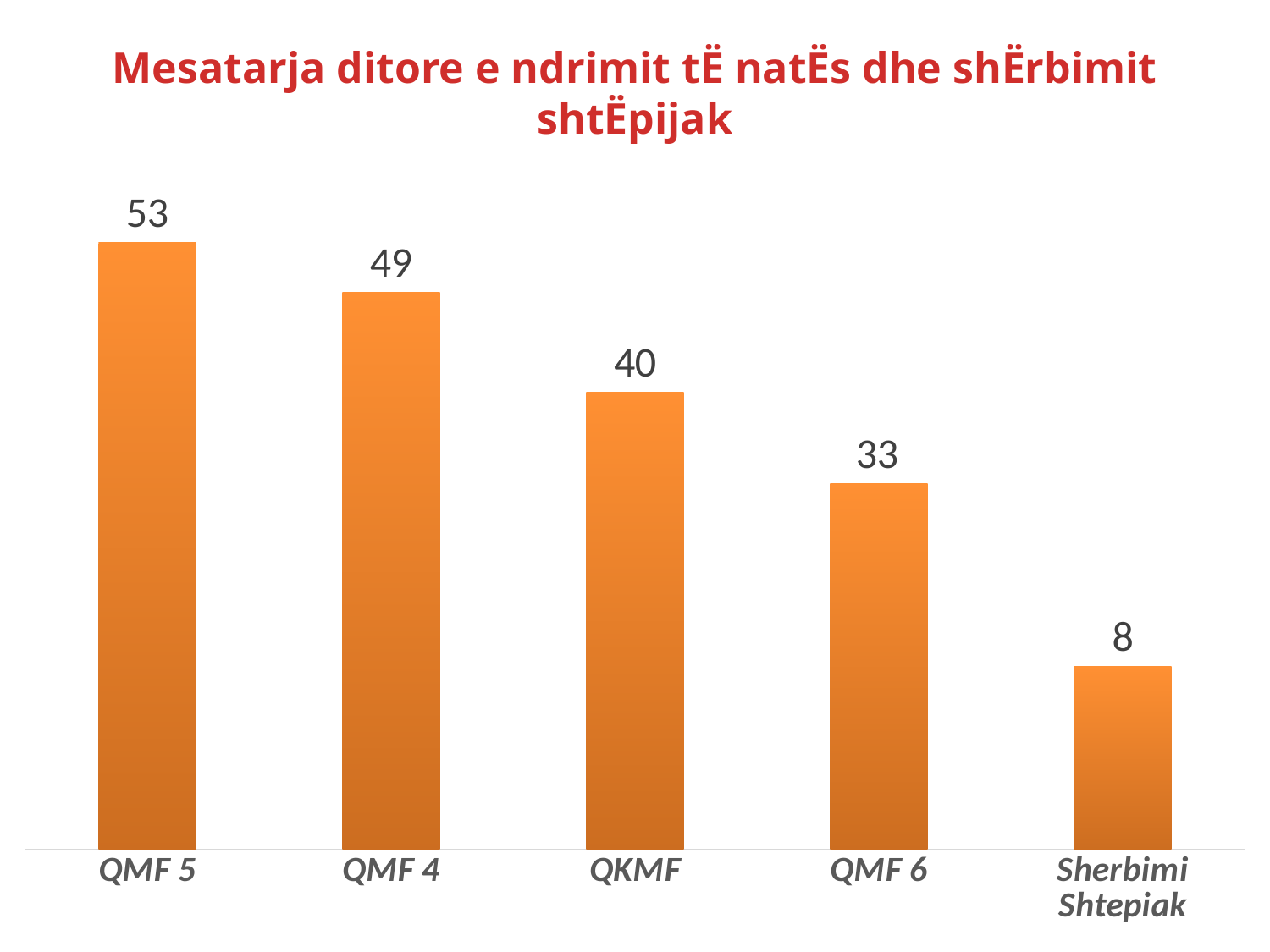
Do the values rise or fall from left to right along the x axis? Fall What is the value for QKMF? 40 What kind of chart is shown on the slide? Bar chart Which category has the lowest value? Sherbimi Shtepiak Which is larger, the value for QMF 4 or the value for QKMF? QMF 4 What is the difference between the values for QMF 5 and QMF 4? 4 What is the value for Sherbimi Shtepiak? 8 What is the difference between the values for QKMF and QMF 6? 7 Which category has the highest value? QMF 5 What is the value for QMF 5? 53 How many categories are shown in the chart? 5 What is the value for QMF 6? 33